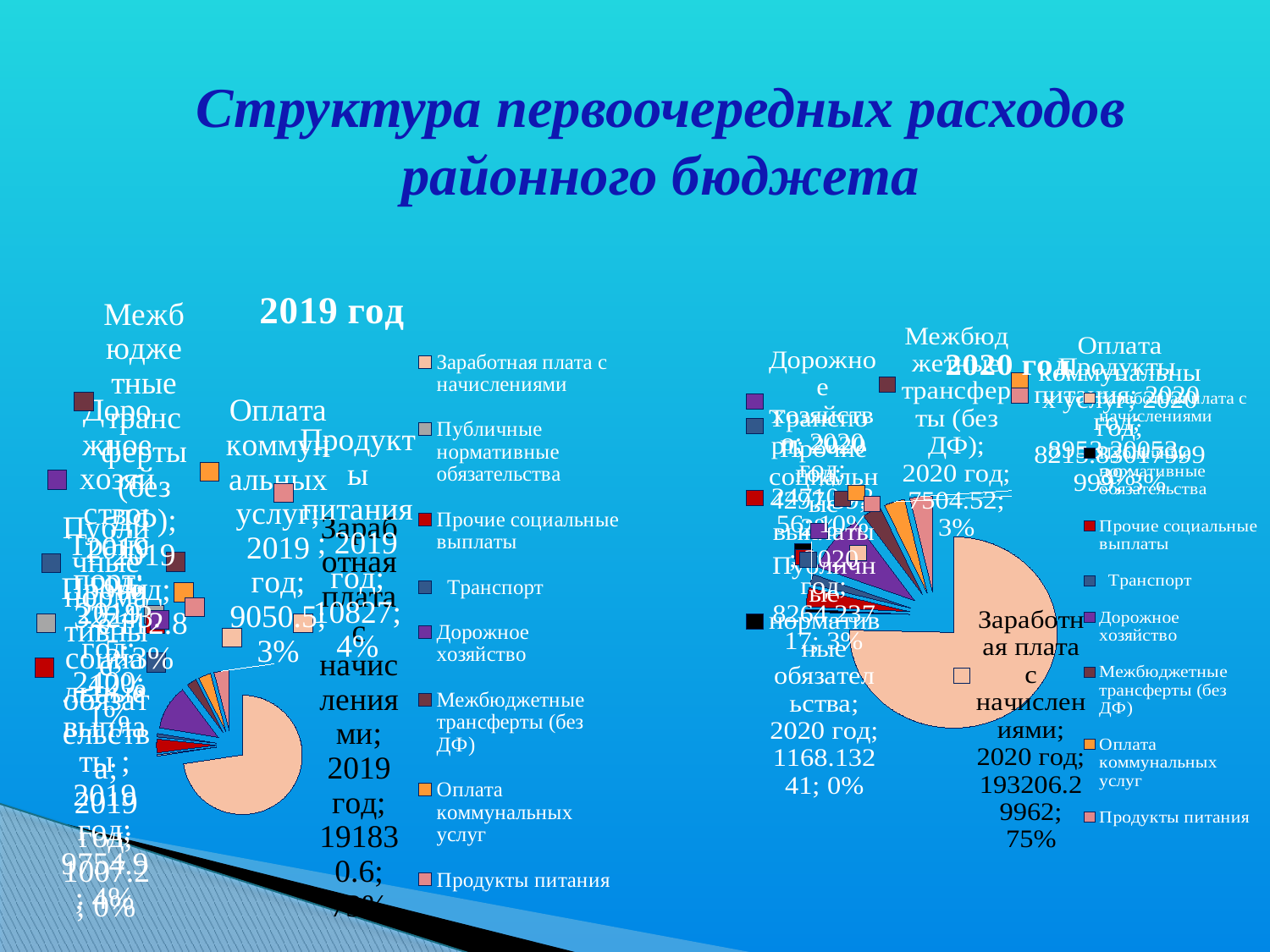
In the 2019 год chart, what is the value for Оплата коммунальных услуг? 9050.5 What type of chart is used on the slide for the 2019 год and 2020 год data? Pie chart How many pie charts are shown on the slide? 2 In the 2020 год chart, what is the value for Заработная плата с начислениями? 193206.29962 In the 2020 год chart, what is the value for Межбюджетные трансферты (без ДФ)? 7504.52 In the 2020 год chart, which category has the largest slice? Заработная плата с начислениями In the 2019 год chart, what is the value for Продукты питания? 10827 In the 2020 год chart, what share of the pie is Заработная плата с начислениями? 75% In the 2020 год chart, what share of the pie is Публичные нормативные обязательства? 0% In the 2019 год chart, how many entries does the legend list? 8 In the 2019 год chart, which is larger: Продукты питания or Оплата коммунальных услуг? Продукты питания What is the title of the slide? Структура первоочередных расходов районного бюджета